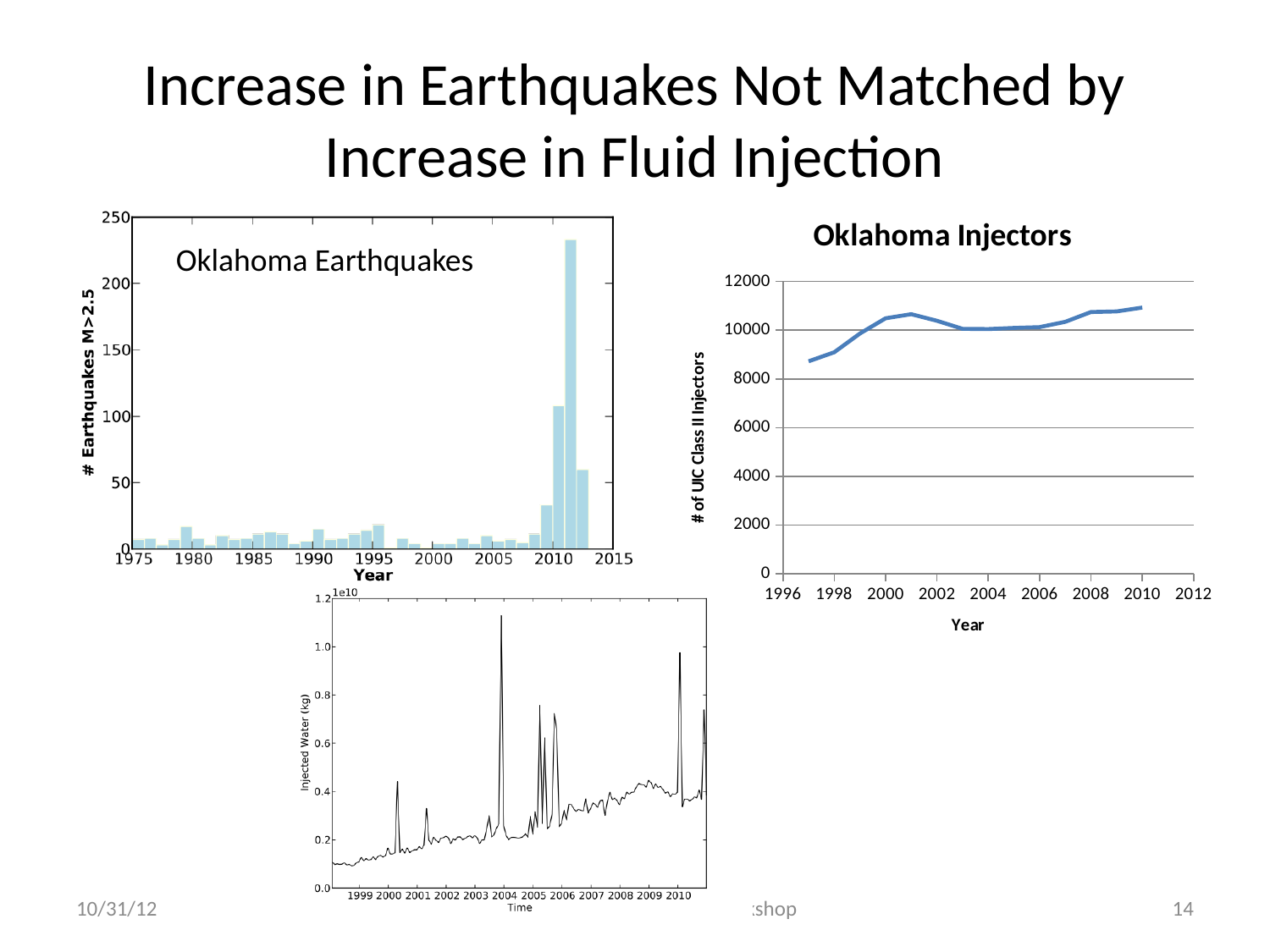
In the Oklahoma Injectors chart, which is larger, the value for 1997 or the value for 2010? 2010 What is the y-axis label of the Oklahoma Injectors chart? # of UIC Class II Injectors In the Oklahoma Injectors chart, is the value for 2010 greater or less than 10000? greater In the Oklahoma Earthquakes chart, which year has the highest number of earthquakes? 2011 In the Oklahoma Earthquakes chart, is the value for 2012 greater or less than 50? greater In the Oklahoma Injectors chart, which year has the lowest number of injectors? 1997 What kind of chart is the Oklahoma Earthquakes chart? bar chart In the bottom chart of Injected Water (kg), do the values generally rise or fall from 1999 to 2010? rise In the Oklahoma Injectors chart, is the value for 1997 greater or less than 10000? less What kind of chart is the Oklahoma Injectors chart? line chart